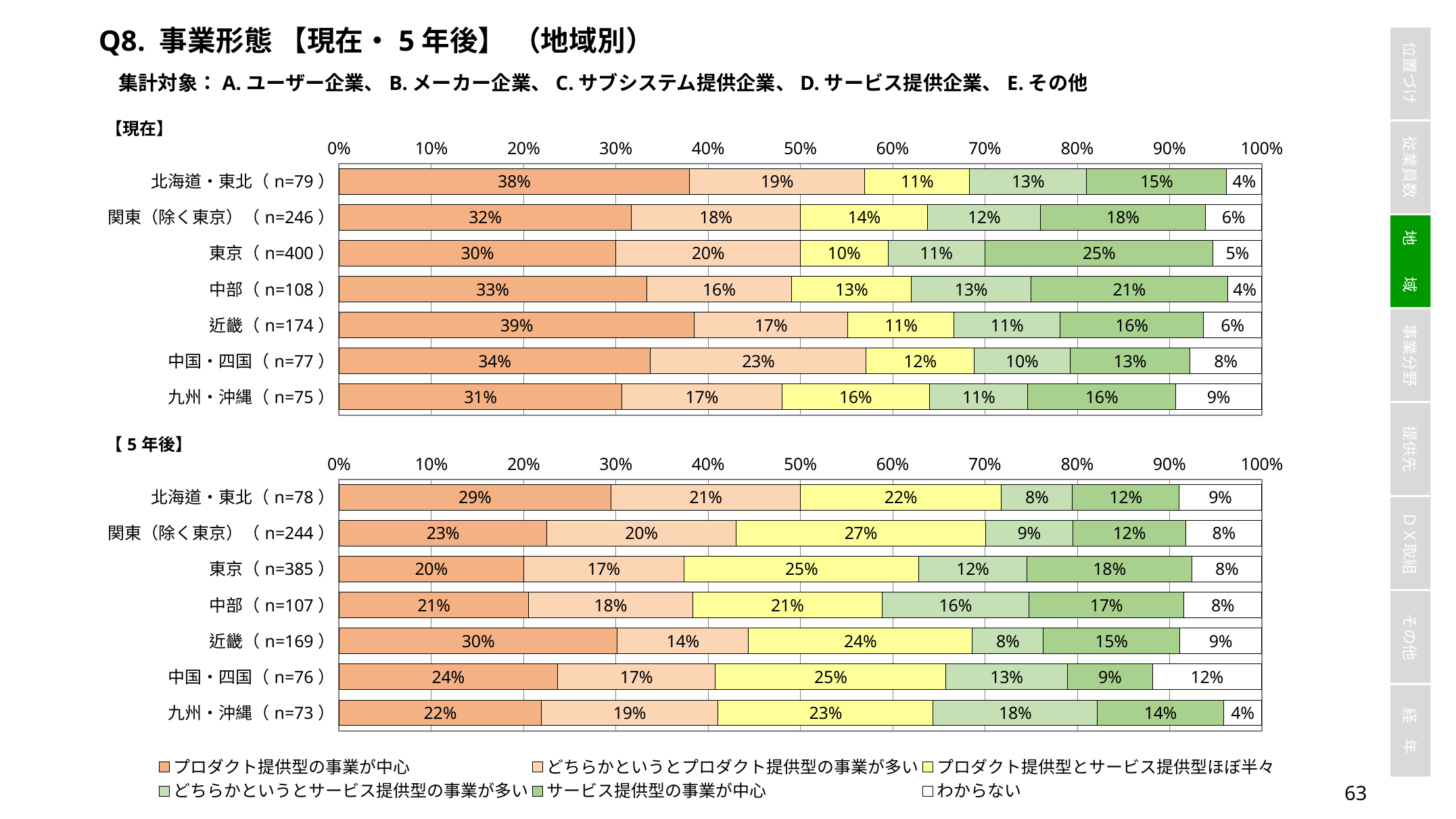
In the 【5年後】 chart, what percentage of 関東（除く東京） respondents answered プロダクト提供型とサービス提供型ほぼ半々? 27% In the 【5年後】 chart, which region has the larger share for わからない: 中国・四国 or 九州・沖縄? 中国・四国 In the 【現在】 chart, what is the sample size (n) shown for 東京? n=400 In the 【5年後】 chart, which region has the lowest share for プロダクト提供型の事業が中心? 東京 In the 【5年後】 chart, which region has the highest share for どちらかというとサービス提供型の事業が多い? 九州・沖縄 In the 【現在】 chart, which region has the highest share for プロダクト提供型の事業が中心? 近畿 What kind of chart is the 【5年後】 chart? Stacked bar chart In the 【現在】 chart, what percentage of 九州・沖縄 respondents answered わからない? 9% How many series does the legend list? 6 In the 【現在】 chart, what is the difference in percentage points between 近畿 and 東京 for プロダクト提供型の事業が中心? 9 percentage points How many regions are shown in the 【現在】 chart? 7 In the 【現在】 chart, what percentage of 東京 respondents answered サービス提供型の事業が中心? 25%